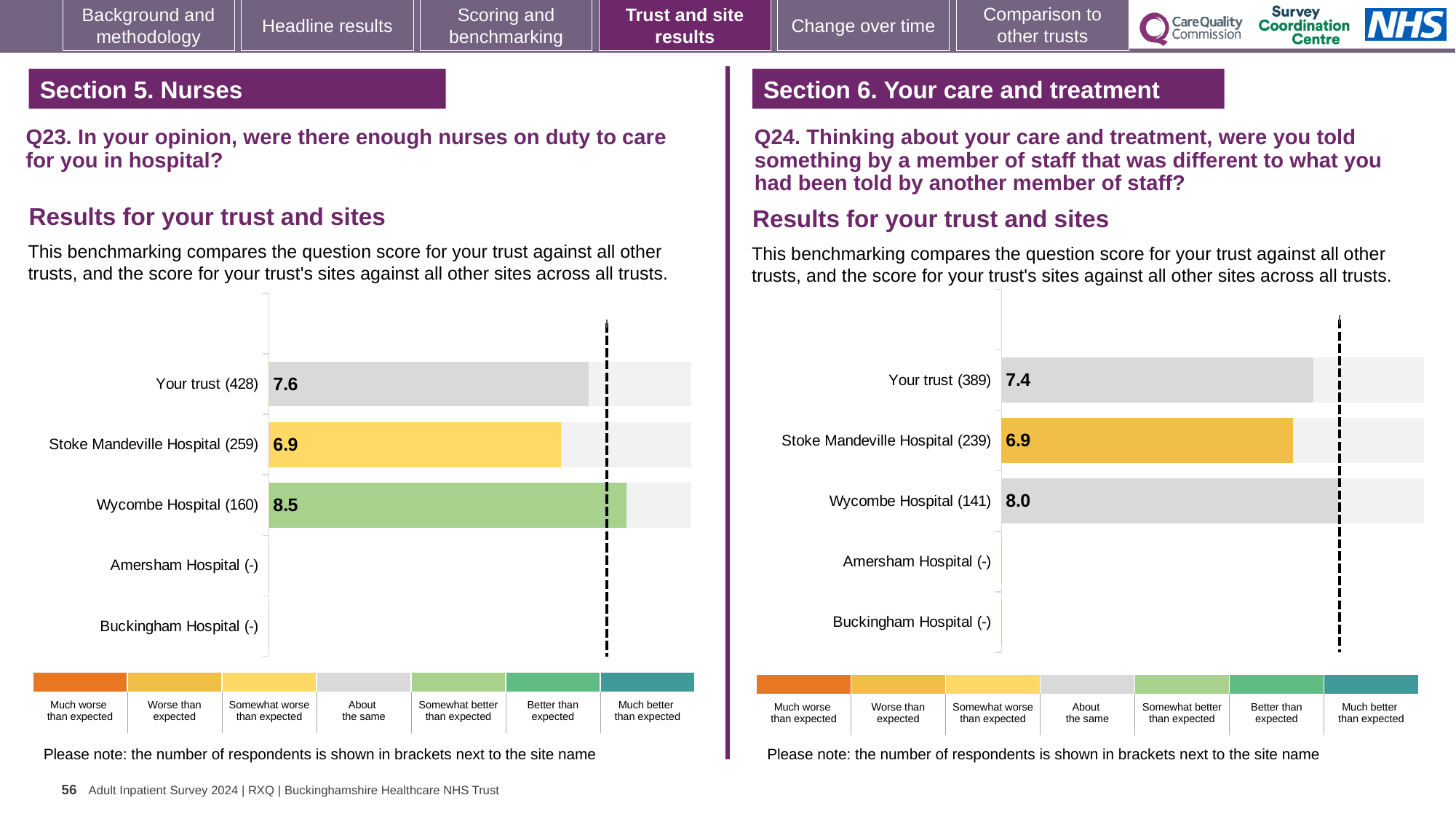
On the Q23 chart (left), what is the difference between the scores for Wycombe Hospital and Stoke Mandeville Hospital? 1.6 On the Q24 chart (right), what is the difference between the scores for Wycombe Hospital and Your trust? 0.6 On the Q23 chart (left), how many respondents are shown in brackets for Stoke Mandeville Hospital? 259 On the Q24 chart (right), which site or trust has the lowest score? Stoke Mandeville Hospital On the Q24 chart (right), which has the higher score, Your trust or Stoke Mandeville Hospital? Your trust On the Q24 chart (right), how many sites or trusts are listed on the vertical axis? 5 On the Q23 chart (left), what is the score for Your trust? 7.6 What kind of chart is used on the Q23 chart (left)? Bar chart On the Q24 chart (right), what is the score for Stoke Mandeville Hospital? 6.9 On the Q24 chart (right), what is the score for Wycombe Hospital? 8.0 On the Q23 chart (left), which site or trust has the highest score? Wycombe Hospital On the Q23 chart (left), what is the score for Wycombe Hospital? 8.5